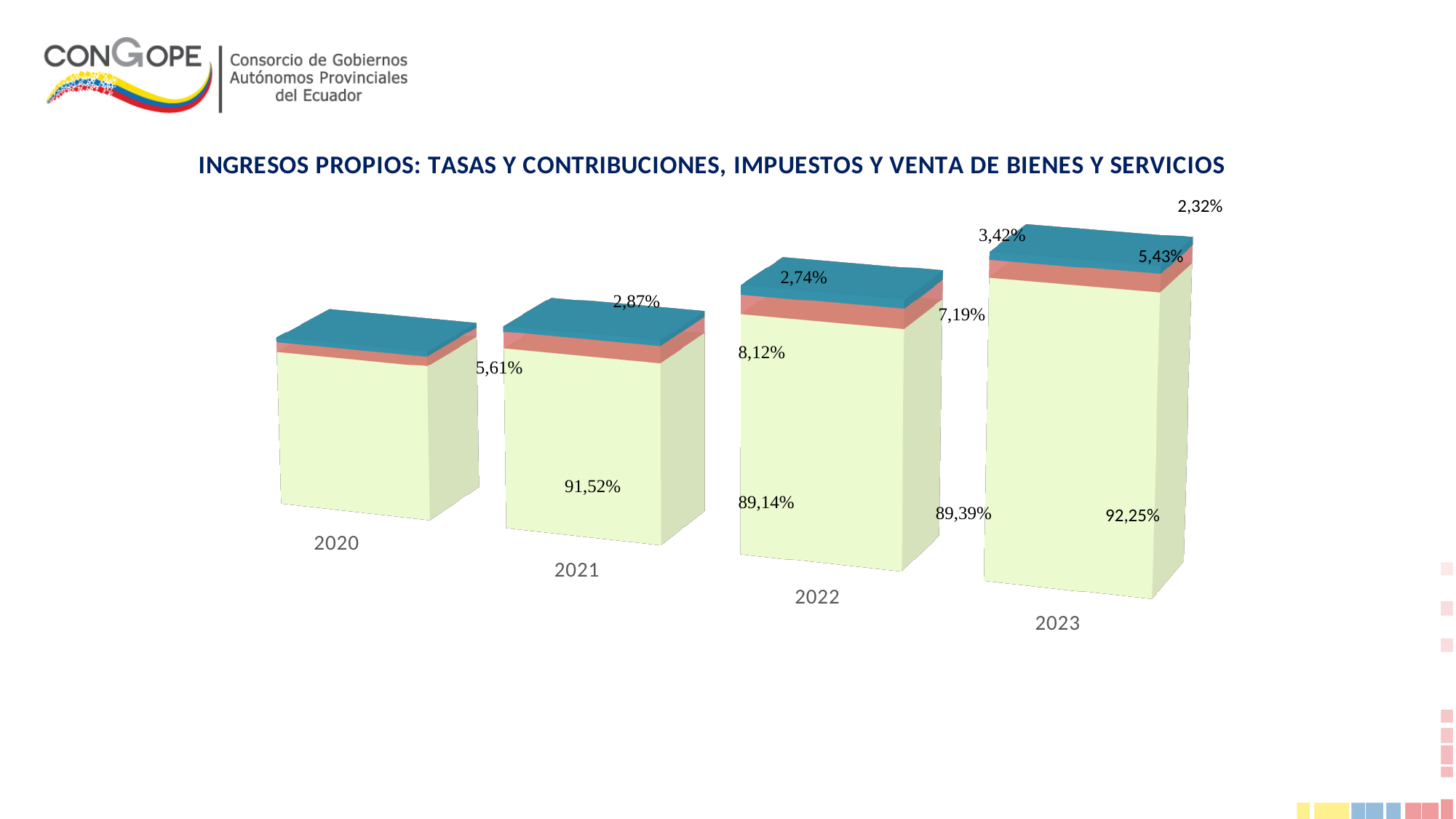
How many segments does each stacked bar contain? 3 Which year is shown under the rightmost bar? 2023 What is the largest percentage value labelled on the chart? 92,25% Which year is shown under the leftmost bar? 2020 Do the bar heights rise or fall from 2020 to 2023? Rise Is the bar for 2021 taller or shorter than the bar for 2022? Shorter Which year's bar is the tallest on the chart? 2023 What is the title of the chart? INGRESOS PROPIOS: TASAS Y CONTRIBUCIONES, IMPUESTOS Y VENTA DE BIENES Y SERVICIOS What kind of chart is shown on the slide? Stacked bar chart What is the smallest percentage value labelled on the chart? 2,32% How many years (bars) are shown on the chart? 4 Which year's bar is the shortest on the chart? 2020